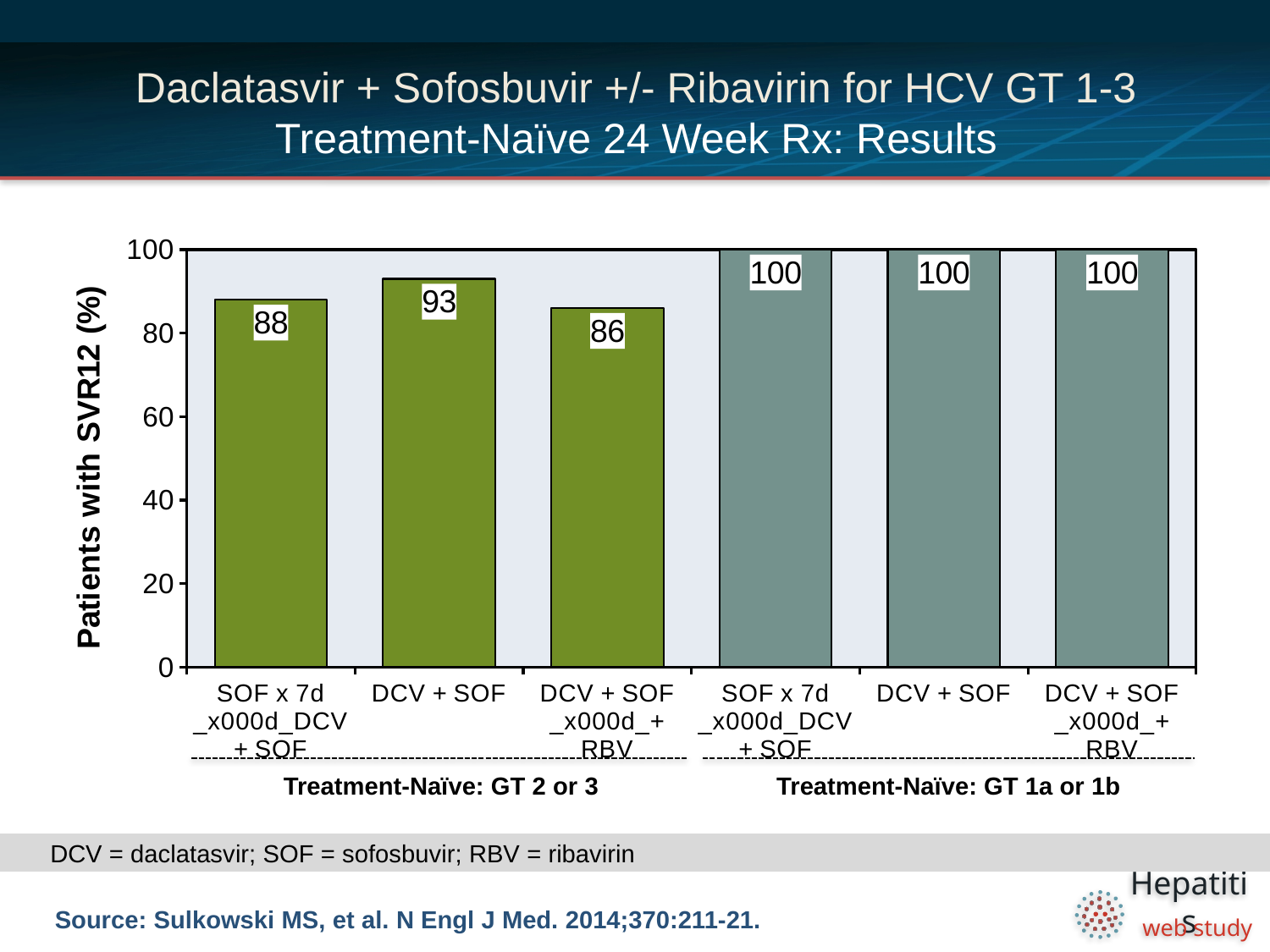
Which regimen has the lowest SVR12 value in the Treatment-Naïve: GT 2 or 3 group? DCV + SOF + RBV What kind of chart is shown on the slide? bar chart Which regimen has the highest SVR12 value in the Treatment-Naïve: GT 2 or 3 group? DCV + SOF What is the difference in SVR12 for DCV + SOF between the GT 1a or 1b group and the GT 2 or 3 group? 7 What is the label of the y-axis? Patients with SVR12 (%) What is the SVR12 value for DCV + SOF in the Treatment-Naïve: GT 2 or 3 group? 93 What is the SVR12 value for SOF x 7d then DCV + SOF in the Treatment-Naïve: GT 2 or 3 group? 88 How many bars are plotted in the chart? 6 What is the SVR12 value for DCV + SOF + RBV in the Treatment-Naïve: GT 1a or 1b group? 100 Which is larger: the SVR12 for SOF x 7d then DCV + SOF in the GT 2 or 3 group, or the same regimen in the GT 1a or 1b group? GT 1a or 1b group What is the SVR12 value for DCV + SOF + RBV in the Treatment-Naïve: GT 2 or 3 group? 86 What is the difference in SVR12 between DCV + SOF and DCV + SOF + RBV in the Treatment-Naïve: GT 2 or 3 group? 7